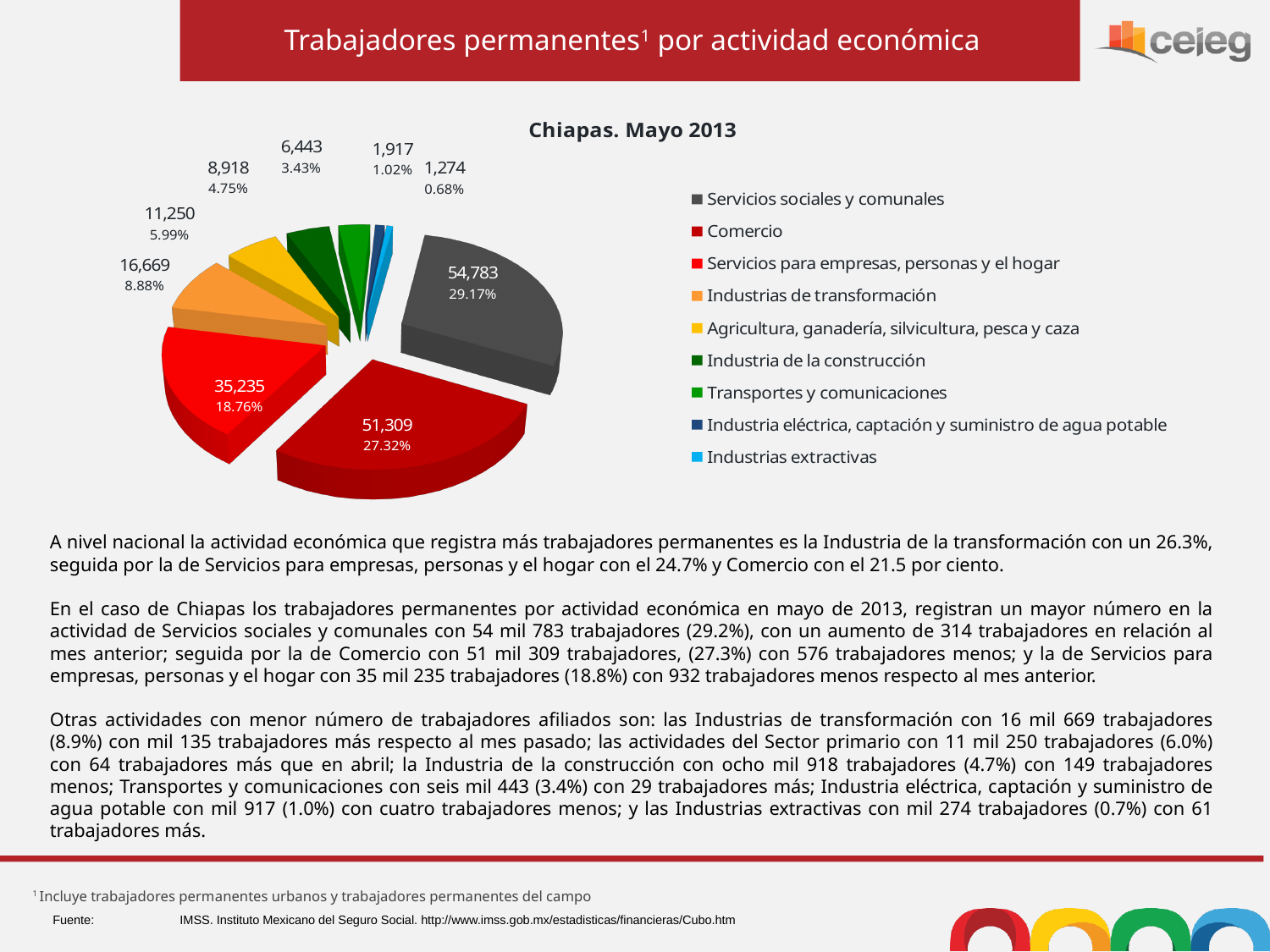
What is the difference between the values for Servicios sociales y comunales and Comercio? 3,474 Which category has the largest slice of the pie chart? Servicios sociales y comunales What percentage share does Servicios para empresas, personas y el hogar have in the pie chart? 18.76% How many categories does the legend of the pie chart list? 9 What is the title of the chart? Chiapas. Mayo 2013 What kind of chart is shown on the slide? Pie chart What is the value shown for Industrias de transformación? 16,669 What percentage share does Industria eléctrica, captación y suministro de agua potable have in the pie chart? 1.02% What is the value shown for Comercio? 51,309 Which category has the smallest slice of the pie chart? Industrias extractivas What is the value shown for Servicios sociales y comunales? 54,783 Which is larger, the value for Agricultura, ganadería, silvicultura, pesca y caza or the value for Industria de la construcción? Agricultura, ganadería, silvicultura, pesca y caza